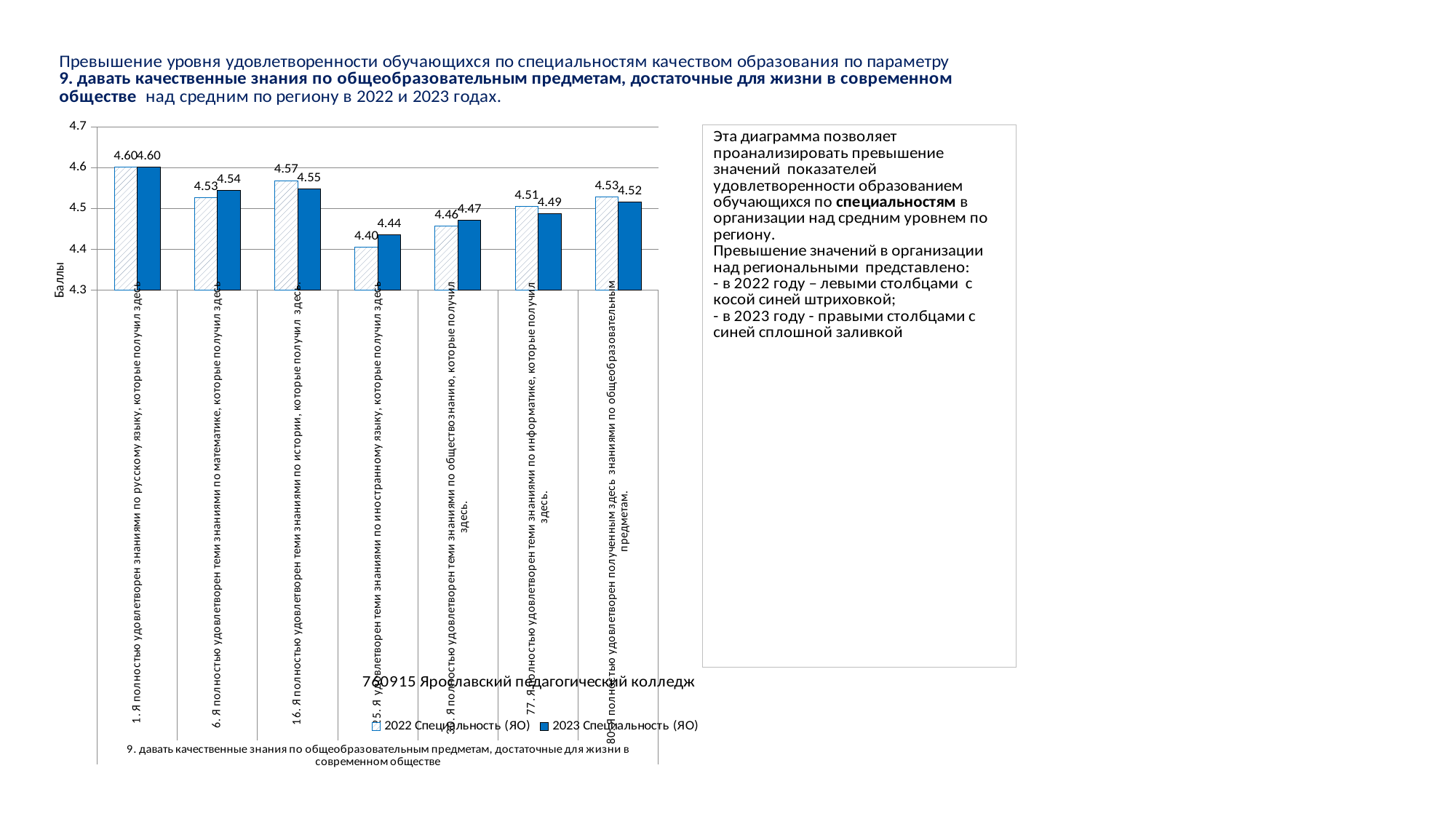
What type of chart is shown on the slide? bar chart Which statement has the highest 2023 Специальность (ЯО) value? 1. Я полностью удовлетворен теми знаниями по русскому языку, которые получил здесь How many series does the chart legend list? 2 For the informatics statement (77. Я полностью удовлетворен теми знаниями по информатике...), which is larger: the 2022 or the 2023 value? 2022 What is the difference between the 2023 and 2022 Специальность (ЯО) values for the foreign language statement (25.)? 0.04 What is the 2023 Специальность (ЯО) value for the statement about knowledge of foreign language (25. Я удовлетворен теми знаниями по иностранному языку...)? 4.44 Which statement has the lowest 2022 Специальность (ЯО) value? 25. Я удовлетворен теми знаниями по иностранному языку, которые получил здесь How many categories (statements) are plotted on the chart? 7 What is the 2022 Специальность (ЯО) value for the statement about knowledge of Russian language (1. Я полностью удовлетворен теми знаниями по русскому языку...)? 4.60 What is the label of the vertical axis of the chart? Баллы What is the 2022 Специальность (ЯО) value for the statement about knowledge of history (16. Я полностью удовлетворен теми знаниями по истории...)? 4.57 Is the 2022 Специальность (ЯО) value for the social studies statement (30. ...по обществознанию...) greater or less than 4.5? less